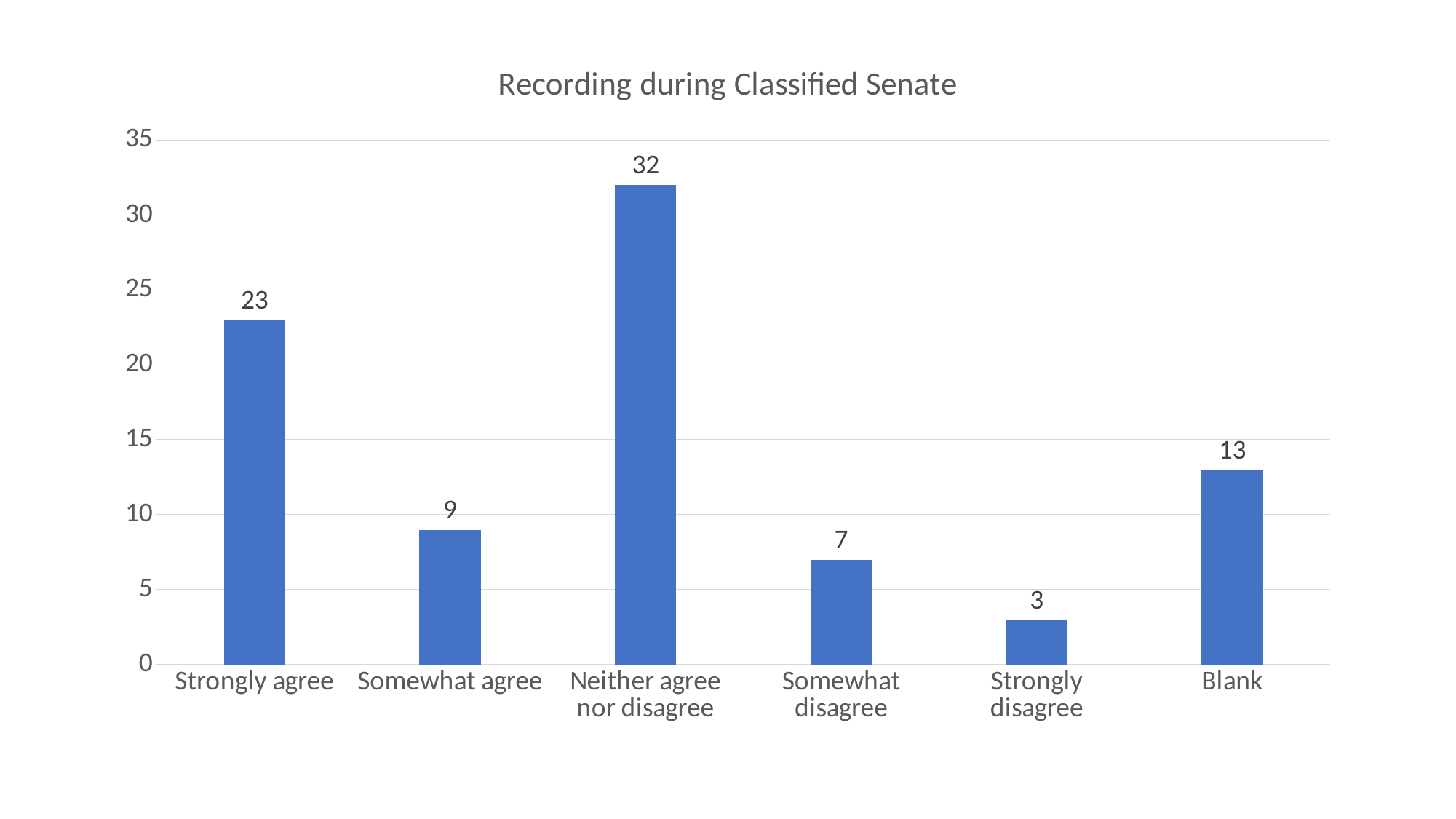
What is the value for Strongly agree? 23 What is the difference between the values for Somewhat agree and Somewhat disagree? 2 What is the value for Neither agree nor disagree? 32 Which category has the lowest value? Strongly disagree What is the difference between the values for Neither agree nor disagree and Strongly agree? 9 Is the value for Strongly agree greater or less than 20? greater How many categories are shown on the x axis? 6 What is the title of the chart? Recording during Classified Senate Which category has the highest value? Neither agree nor disagree What kind of chart is shown? bar chart What is the value for Blank? 13 Which is larger, the value for Blank or the value for Somewhat agree? Blank